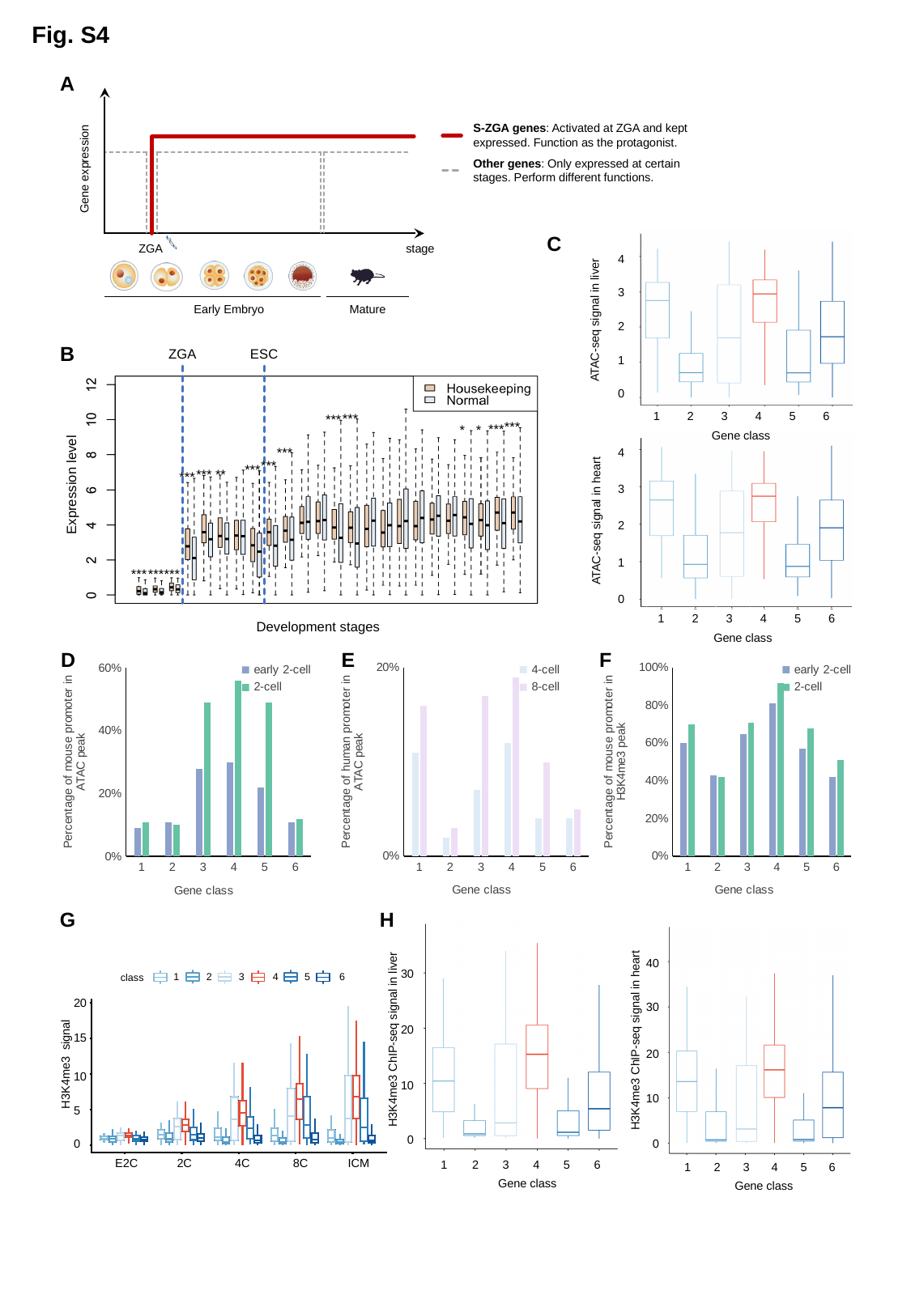
In panel D (Percentage of mouse promoter in ATAC peak), is the 2-cell value for gene class 4 greater or less than 40%? greater What kind of chart is panel D (Percentage of mouse promoter in ATAC peak)? bar chart In panel D (Percentage of mouse promoter in ATAC peak), which is larger for gene class 3: the early 2-cell bar or the 2-cell bar? 2-cell How many gene classes are shown on the x axis of panel F (Percentage of mouse promoter in H3K4me3 peak)? 6 In panel E (Percentage of human promoter in ATAC peak), is the 8-cell value for gene class 4 greater or less than 10%? greater In panel H (H3K4me3 ChIP-seq signal in liver), which gene class has the highest median? 4 In panel D (Percentage of mouse promoter in ATAC peak), which gene class has the highest 2-cell bar? 4 In panel E (Percentage of human promoter in ATAC peak), which gene class has the lowest 4-cell bar? 2 In panel F (Percentage of mouse promoter in H3K4me3 peak), is the early 2-cell value for gene class 2 greater or less than 60%? less In panel F (Percentage of mouse promoter in H3K4me3 peak), which gene class has the highest 2-cell bar? 4 In panel D (Percentage of mouse promoter in ATAC peak), how many series does the legend list? 2